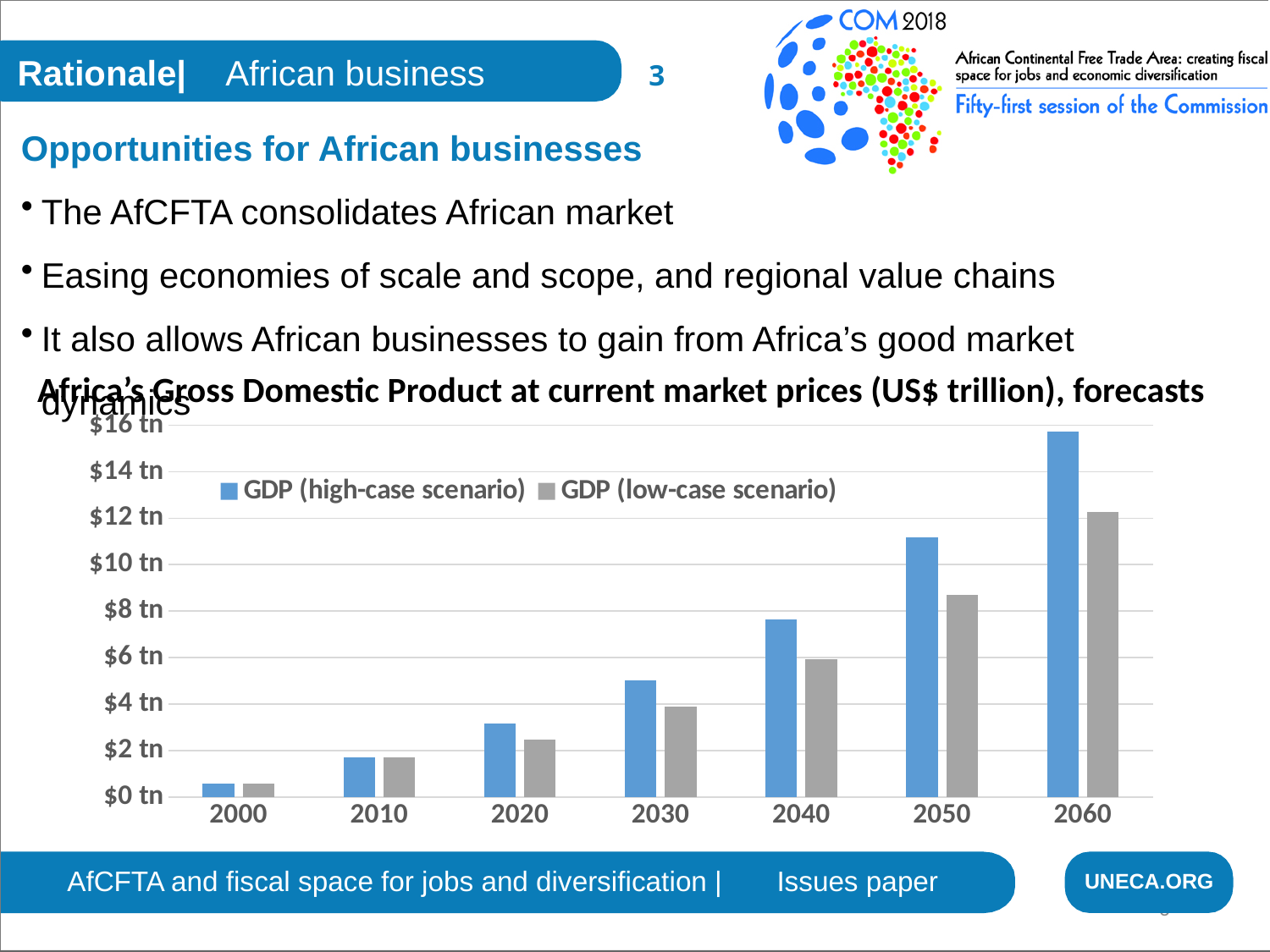
How many years are shown along the x axis of the chart? 7 Is the GDP (high-case scenario) value for 2050 greater or less than $10 tn? greater How many series does the chart's legend list? 2 In which year is the GDP (low-case scenario) bar the lowest? 2000 Is the GDP (low-case scenario) value for 2010 greater or less than $2 tn? less What colour are the GDP (low-case scenario) bars in the chart? grey For 2060, which is larger: the GDP (high-case scenario) bar or the GDP (low-case scenario) bar? GDP (high-case scenario) In which year is the GDP (high-case scenario) bar the highest? 2060 Is the GDP (high-case scenario) value for 2040 greater or less than $8 tn? less What kind of chart is shown on the slide? bar chart Do the GDP (high-case scenario) values rise or fall from 2000 to 2060? rise